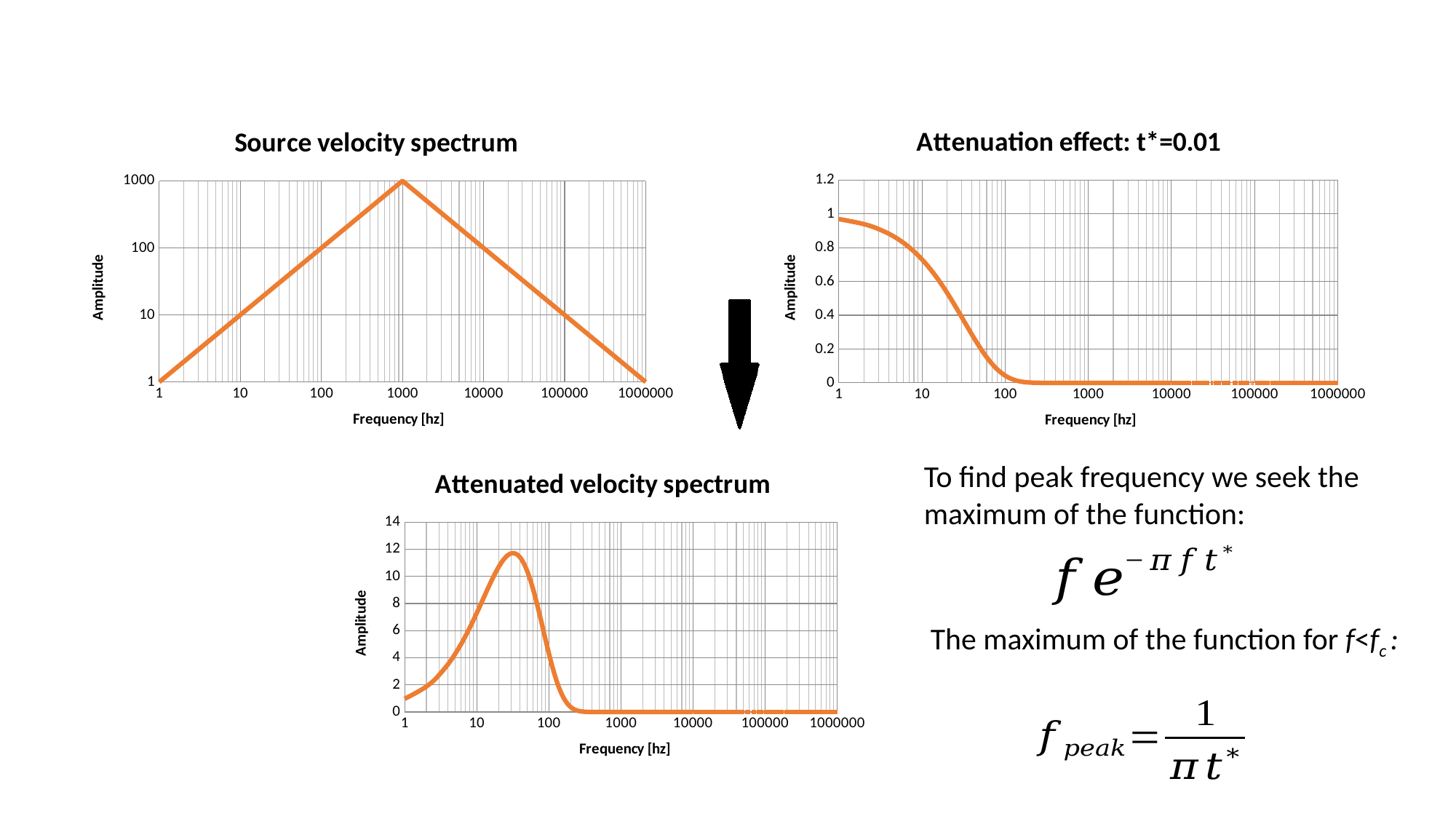
What is the label of the x axis on the 'Attenuated velocity spectrum' chart? Frequency [hz] In the 'Attenuation effect: t*=0.01' chart, is the amplitude at 100 Hz greater or less than 0.2? less How many charts are shown on the slide? 3 In the 'Source velocity spectrum' chart, does the amplitude rise or fall as frequency increases from 1000 to 1000000 Hz? fall In the 'Attenuated velocity spectrum' chart, is the peak amplitude greater or less than 10? greater In the 'Source velocity spectrum' chart, what is the amplitude at a frequency of 10 Hz? 10 In the 'Source velocity spectrum' chart, what is the peak amplitude value? 1000 In the 'Attenuation effect: t*=0.01' chart, does the amplitude rise or fall as frequency increases? fall In the 'Attenuation effect: t*=0.01' chart, is the amplitude at 1 Hz greater or less than 0.8? greater What kind of chart is the 'Source velocity spectrum' chart? line chart In the 'Source velocity spectrum' chart, at what frequency does the amplitude reach its maximum? 1000